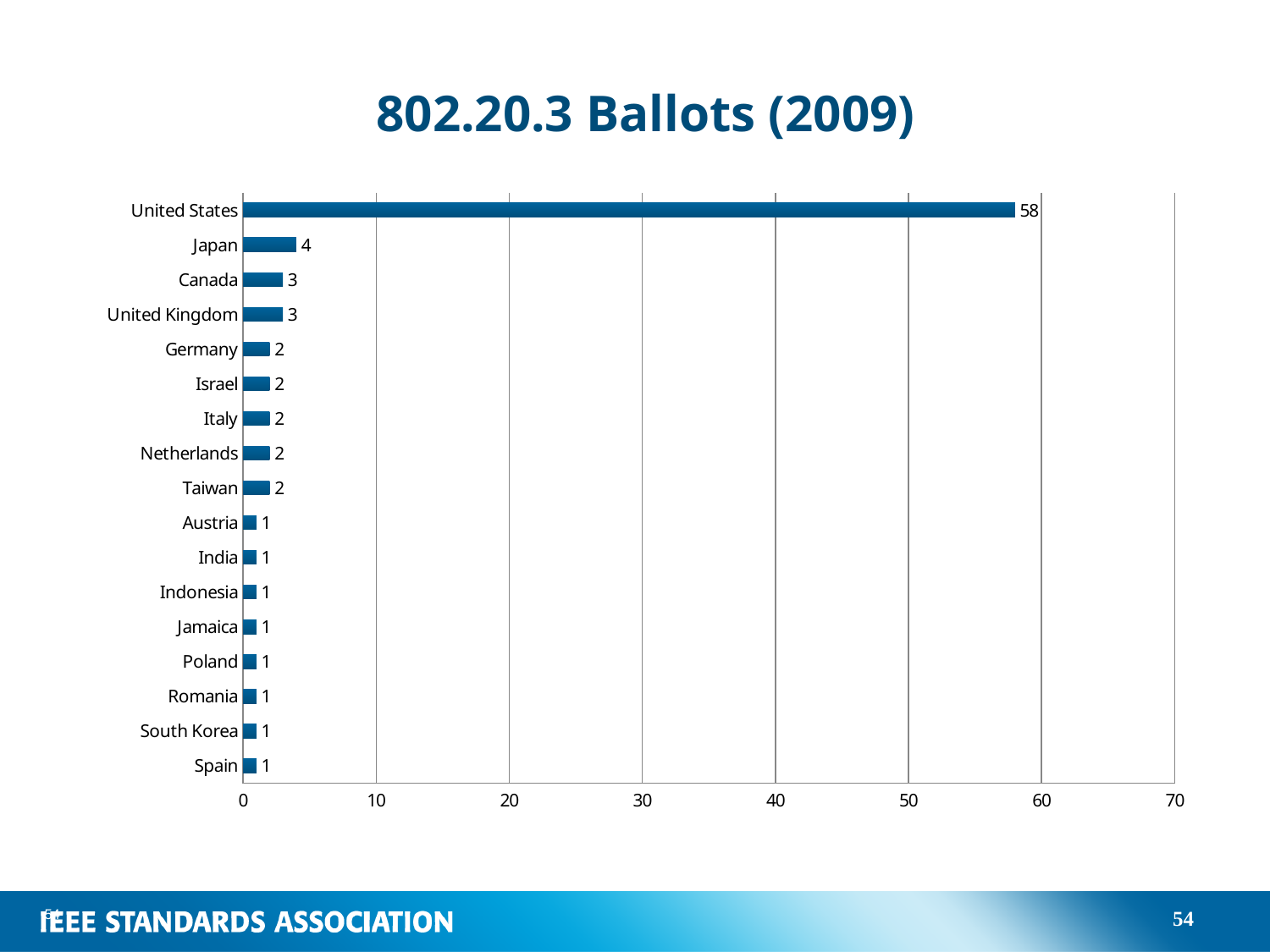
Which is larger, the value for Japan or the value for United Kingdom? Japan What is the value for United States? 58 What is the value for Canada? 3 Is the value for United States greater or less than 50? greater Which country has the highest number of ballots? United States What is the title of the chart? 802.20.3 Ballots (2009) What is the value for Japan? 4 What is the difference between the values for United States and Japan? 54 What kind of chart is shown on the slide? bar chart What is the value for Germany? 2 What is the difference between the values for Japan and Canada? 1 How many countries are shown in the chart? 17